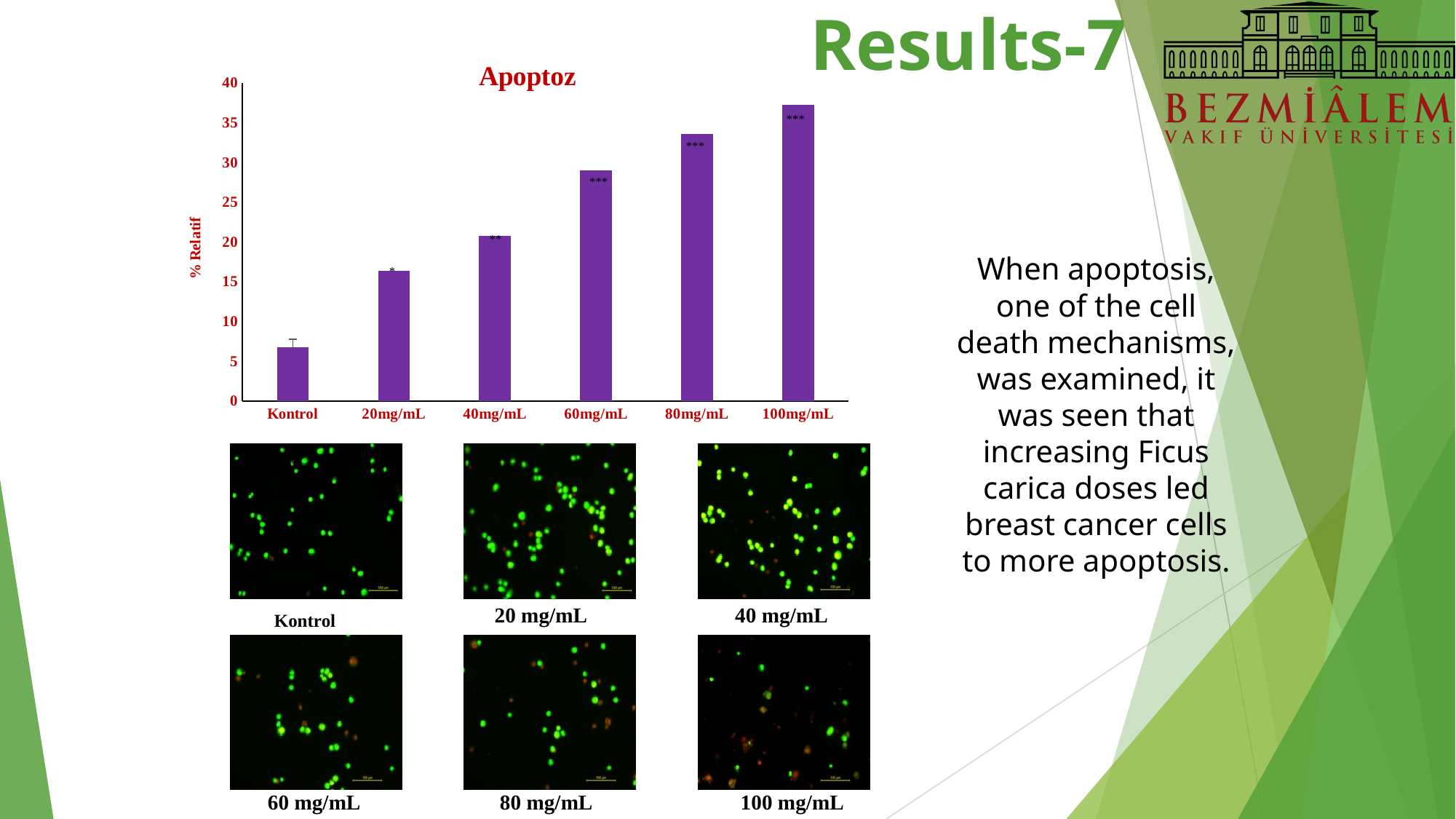
Is the value for 100mg/mL greater or less than 35? greater Which category has the lowest value in the chart? Kontrol What is the title of the chart? Apoptoz What kind of chart is shown on the slide? bar chart Is the value for 60mg/mL greater or less than 25? greater What is the label of the y axis of the chart? % Relatif Which category has the highest value in the chart? 100mg/mL Is the value for 20mg/mL greater or less than 15? greater Do the values rise or fall from Kontrol to 100mg/mL along the x axis? rise How many categories are shown on the x axis of the chart? 6 Which has the larger value, 40mg/mL or 60mg/mL? 60mg/mL